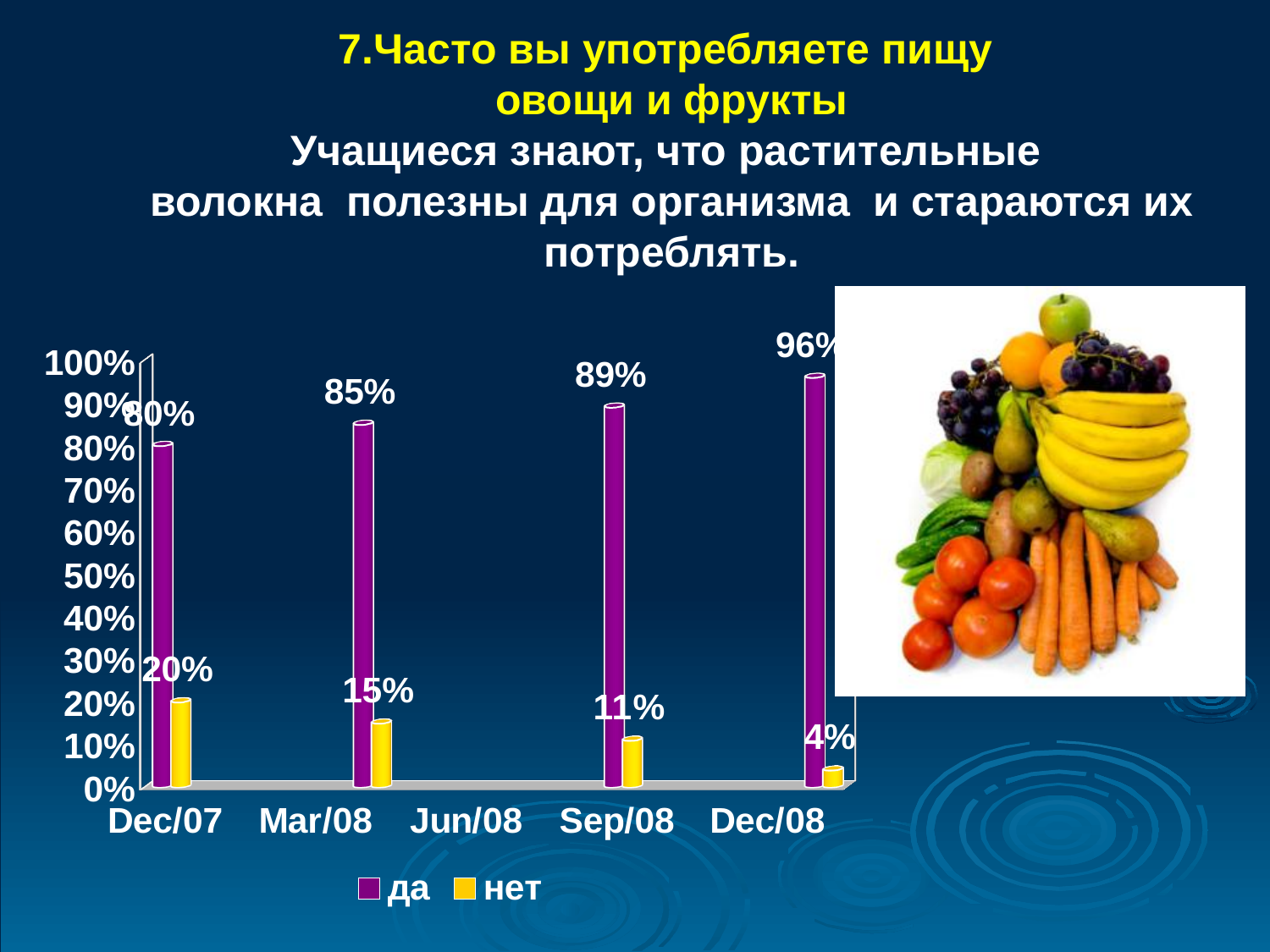
How many groups of bars are plotted on the chart? 4 What are the two series named in the legend? да and нет What is the difference between the highest "да" value (96%) and the lowest "да" value (80%)? 16 percentage points How many series does the legend list? 2 Do the values of the "да" series rise or fall from left to right? rise What kind of chart is shown on the slide? bar chart In the second group of bars, which is larger: the "да" value (85%) or the "нет" value (15%)? да (85%) What is the value of the "да" series for the first group of bars (Dec/07)? 80% What is the highest value of the "да" series? 96% What is the value of the "нет" series for the first group of bars (Dec/07)? 20% What is the lowest value of the "нет" series? 4% Do the values of the "нет" series rise or fall from left to right? fall